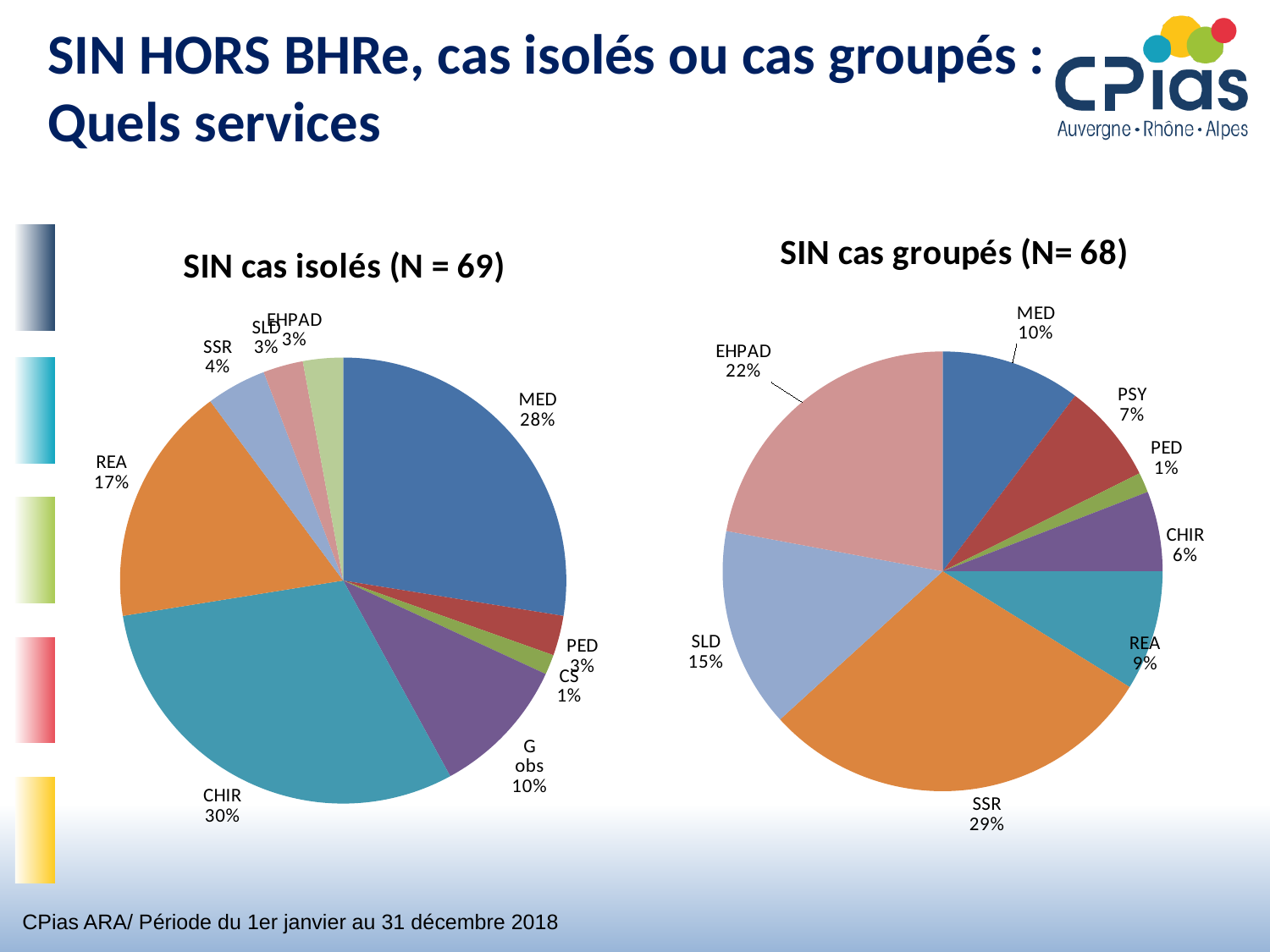
In the 'SIN cas groupés (N= 68)' chart, which is larger, the share of MED or the share of REA? MED In the 'SIN cas isolés (N = 69)' chart, which service has the largest share? CHIR In the 'SIN cas isolés (N = 69)' chart, which service has the smallest share? CS In the 'SIN cas groupés (N= 68)' chart, which service has the smallest share? PED In the 'SIN cas isolés (N = 69)' chart, how many services are shown? 9 What type of chart is used on this slide? Pie chart In the 'SIN cas groupés (N= 68)' chart, what share does SLD have? 15% In the 'SIN cas isolés (N = 69)' chart, what is the difference between the shares of MED and G obs? 18 percentage points In the 'SIN cas isolés (N = 69)' chart, what share does CHIR have? 30% In the 'SIN cas isolés (N = 69)' chart, what share does REA have? 17% In the 'SIN cas groupés (N= 68)' chart, what share does EHPAD have? 22% In the 'SIN cas groupés (N= 68)' chart, which service has the largest share? SSR